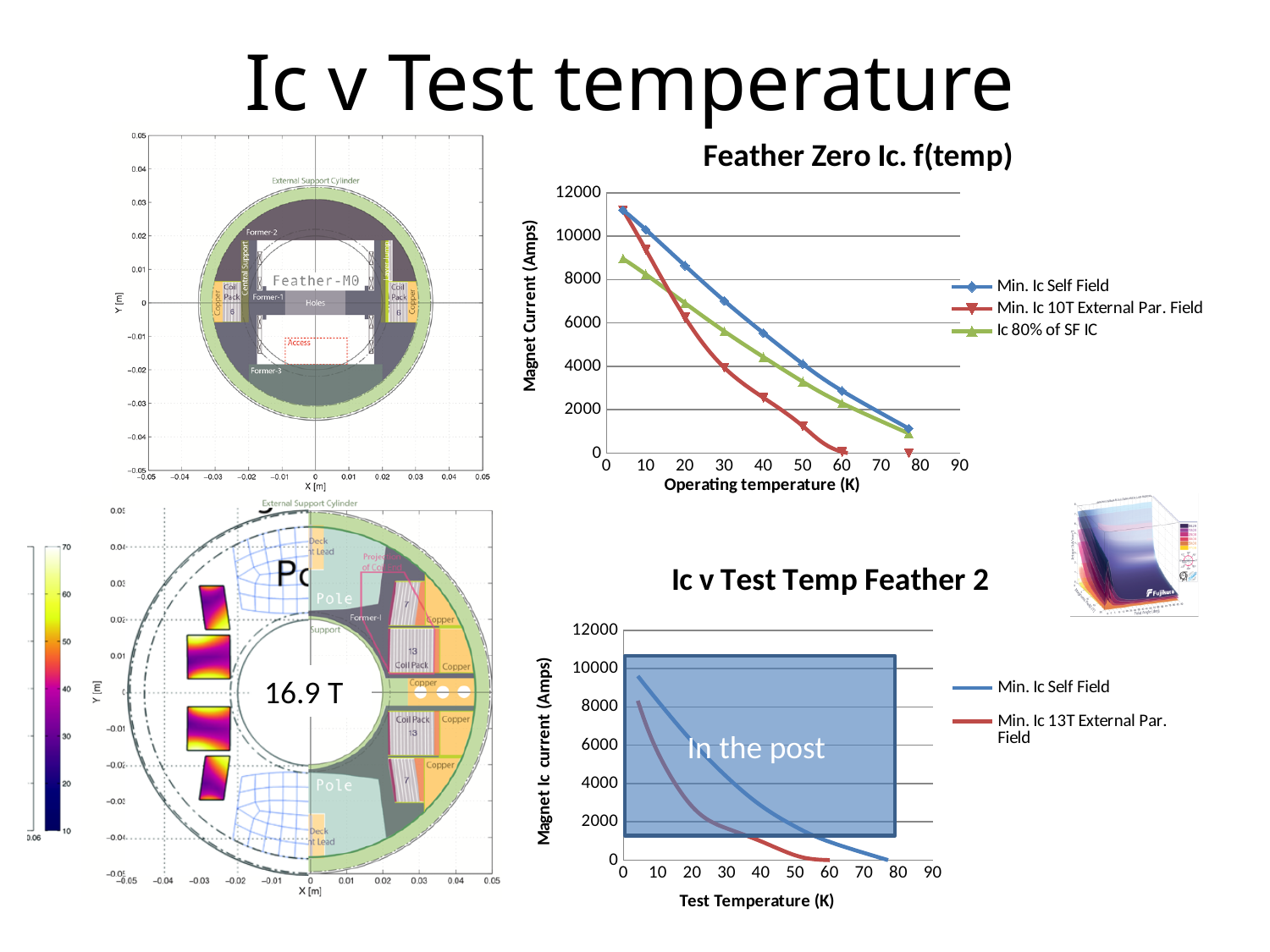
What is the x-axis label of the 'Feather Zero Ic. f(temp)' chart? Operating temperature (K) In the 'Feather Zero Ic. f(temp)' chart, is the value for Min. Ic Self Field at 20 K greater or less than 8000? greater In the 'Ic v Test Temp Feather 2' chart, do the values of Min. Ic 13T External Par. Field rise or fall as test temperature increases? fall How many series does the legend of the 'Feather Zero Ic. f(temp)' chart list? 3 In the 'Feather Zero Ic. f(temp)' chart, which series has the lowest value at 60 K? Min. Ic 10T External Par. Field What is the y-axis label of the 'Ic v Test Temp Feather 2' chart? Magnet Ic current (Amps) In the 'Ic v Test Temp Feather 2' chart, is the value for Min. Ic Self Field at 40 K greater or less than 6000? less In the 'Feather Zero Ic. f(temp)' chart, is the value for Min. Ic 10T External Par. Field at 30 K greater or less than 6000? less What kind of chart is the 'Feather Zero Ic. f(temp)' chart? line chart How many series does the legend of the 'Ic v Test Temp Feather 2' chart list? 2 In the 'Feather Zero Ic. f(temp)' chart, at 20 K, which is larger: Min. Ic Self Field or Min. Ic 10T External Par. Field? Min. Ic Self Field In the 'Feather Zero Ic. f(temp)' chart, do the values of Min. Ic Self Field rise or fall as operating temperature increases? fall